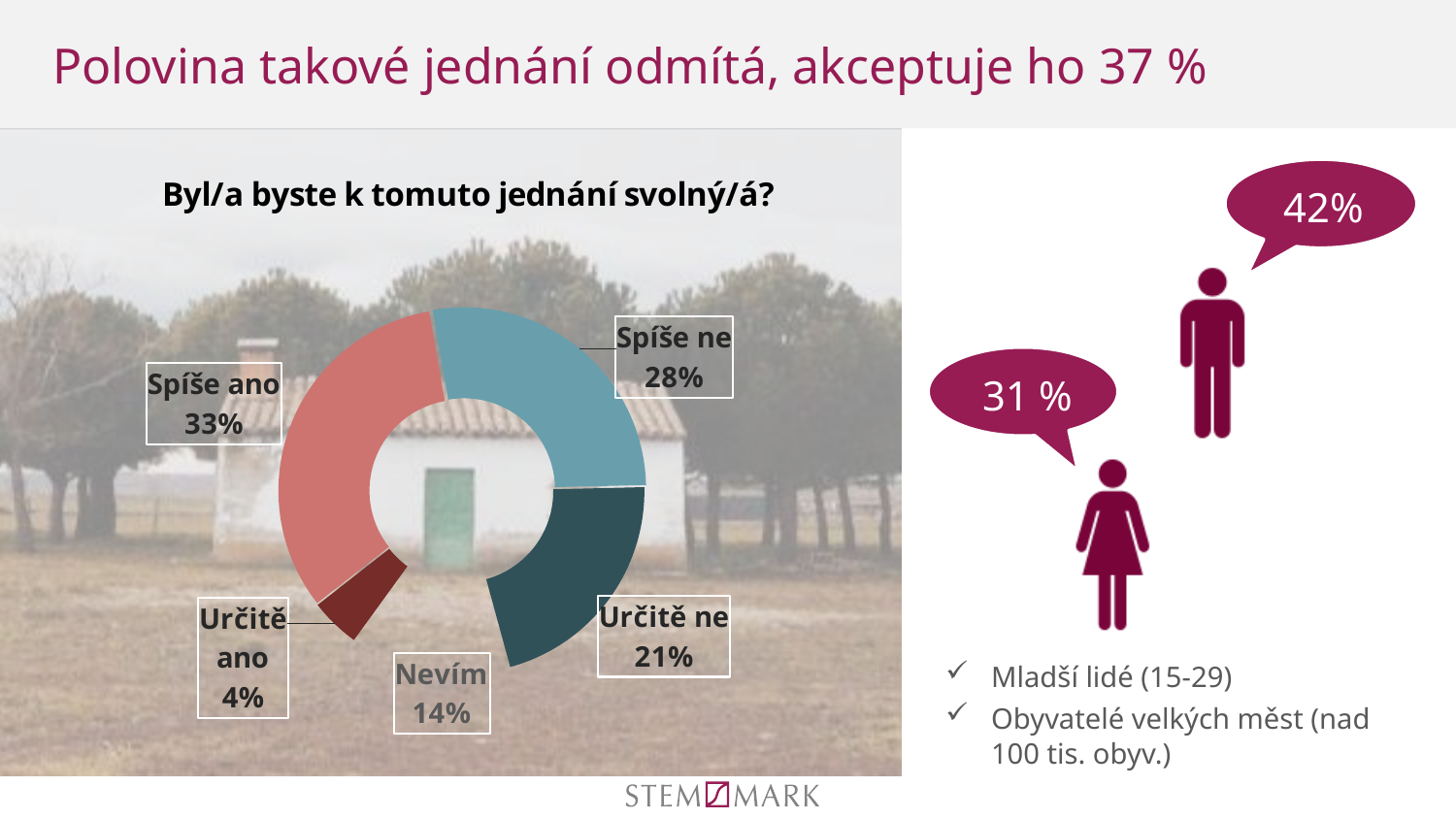
Which answer category has the smallest share in the chart? Určitě ano What kind of chart is shown on the slide? Donut (pie) chart What share of respondents answered "Určitě ne"? 21% Which is larger, the share for "Určitě ne" or the share for "Nevím"? Určitě ne What share of respondents answered "Spíše ne"? 28% What is the title of the chart? Byl/a byste k tomuto jednání svolný/á? What share of respondents answered "Určitě ano"? 4% How many answer categories does the chart show? 5 What is the difference in percentage points between "Spíše ano" and "Spíše ne"? 5 percentage points What share of respondents answered "Nevím"? 14% Which answer category has the largest share in the chart? Spíše ano What share of respondents answered "Spíše ano"? 33%